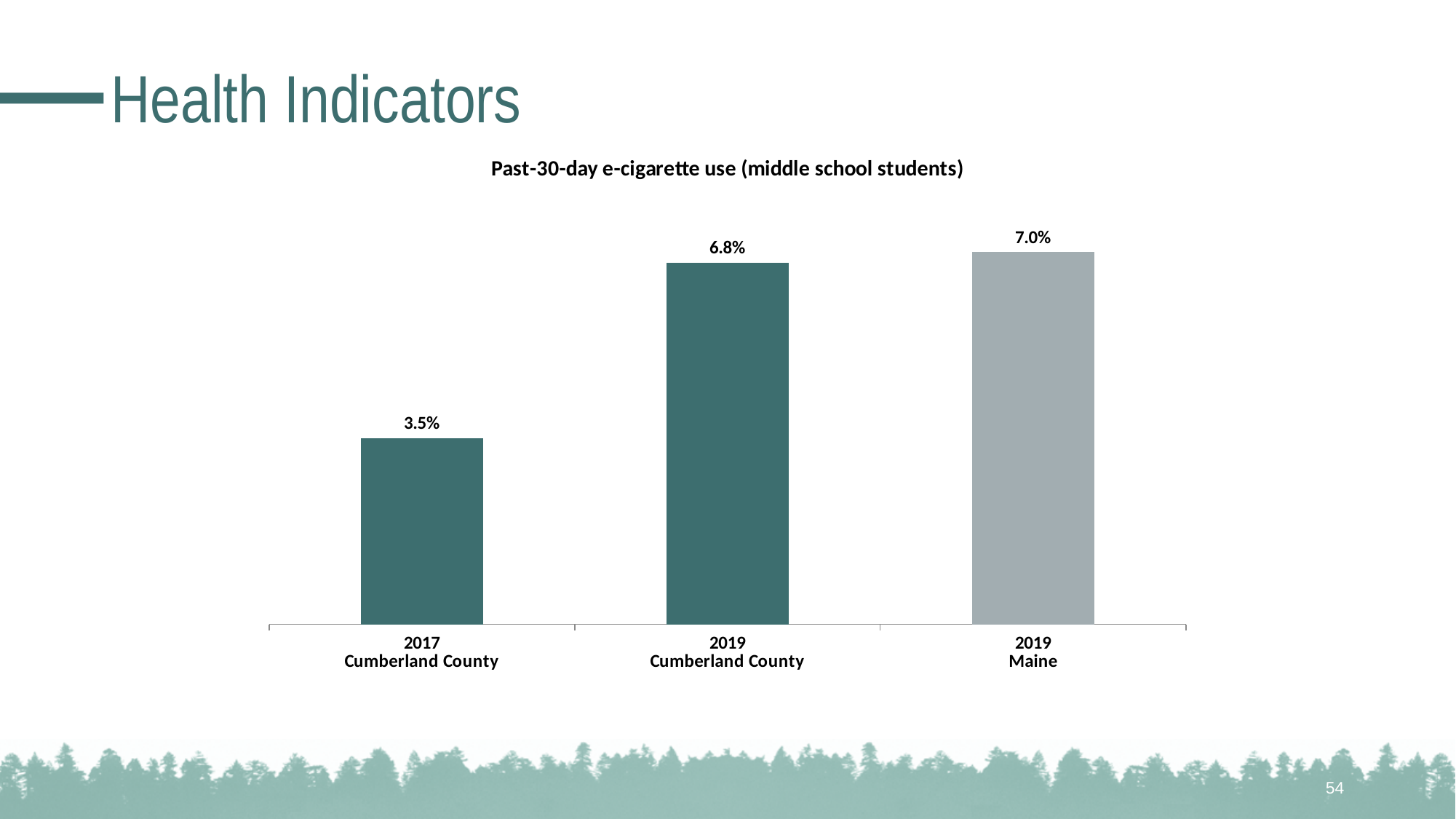
What is the title of the chart? Past-30-day e-cigarette use (middle school students) Which bar shows the lowest past-30-day e-cigarette use rate? 2017 Cumberland County How many bars are shown in the chart? 3 What is the past-30-day e-cigarette use rate for Maine middle school students in 2019? 7.0% What is the difference between the 2019 Maine rate and the 2019 Cumberland County rate? 0.2 percentage points Did past-30-day e-cigarette use among Cumberland County middle school students rise or fall from 2017 to 2019? Rise By how many percentage points did past-30-day e-cigarette use in Cumberland County change from 2017 to 2019? 3.3 percentage points Which is larger: the 2019 Cumberland County rate or the 2017 Cumberland County rate? 2019 Cumberland County What is the past-30-day e-cigarette use rate for Cumberland County middle school students in 2019? 6.8% What type of chart is shown on the slide? Bar chart Which bar shows the highest past-30-day e-cigarette use rate? 2019 Maine What is the past-30-day e-cigarette use rate for Cumberland County middle school students in 2017? 3.5%